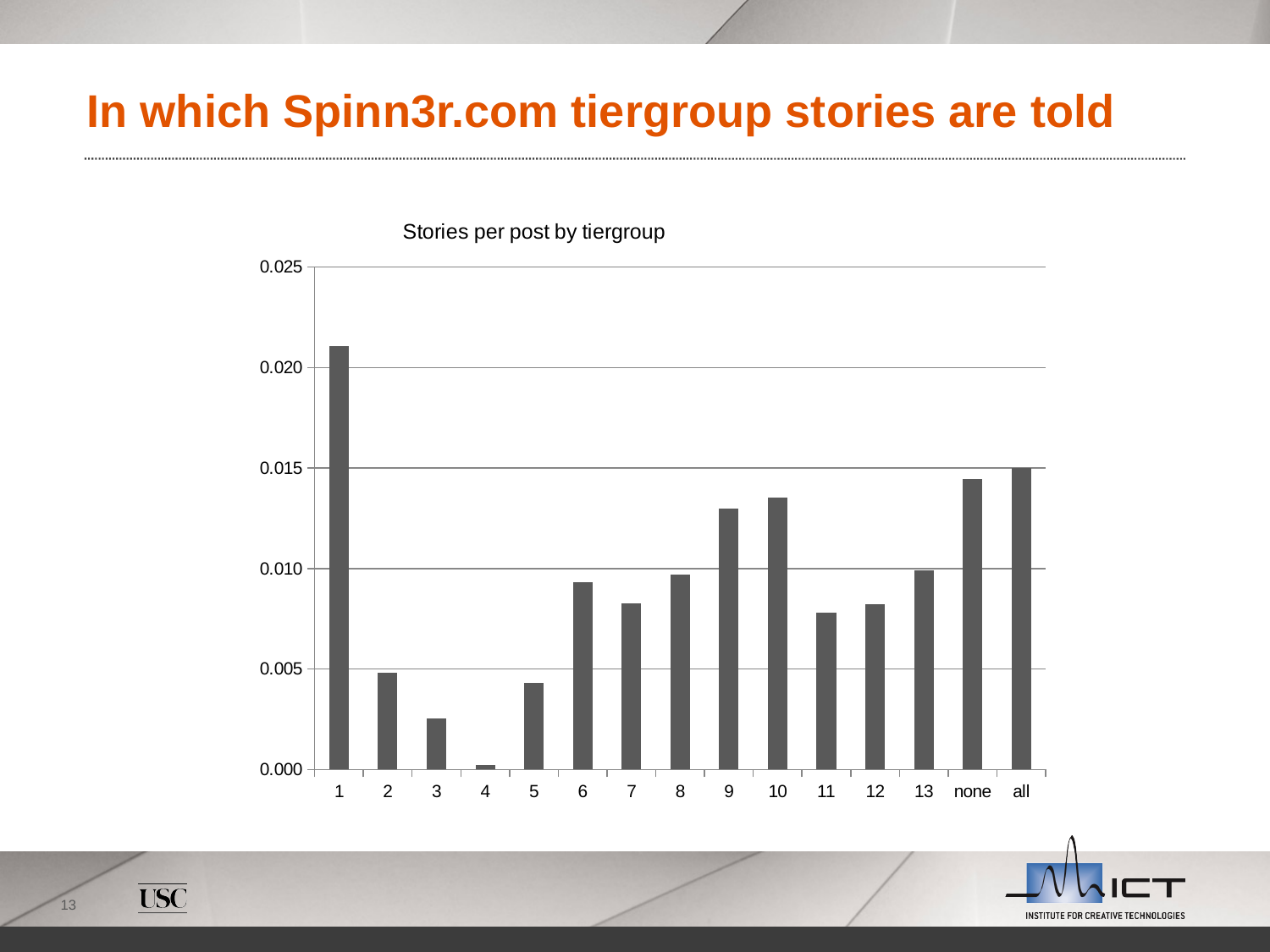
Which has a higher value, tiergroup 1 or tiergroup 2? 1 Which tiergroup has the lowest stories per post? 4 How many categories are shown on the x axis of the chart? 15 Is the value for tiergroup 4 greater or less than 0.005? less Which has a higher value, tiergroup 3 or tiergroup 9? 9 What type of chart is shown on the slide? bar chart Is the value for tiergroup 6 greater or less than 0.010? less Which has a higher value, tiergroup 6 or tiergroup 7? 6 What is the title of the chart? Stories per post by tiergroup Is the value for tiergroup 9 greater or less than 0.010? greater Which tiergroup has the highest stories per post? 1